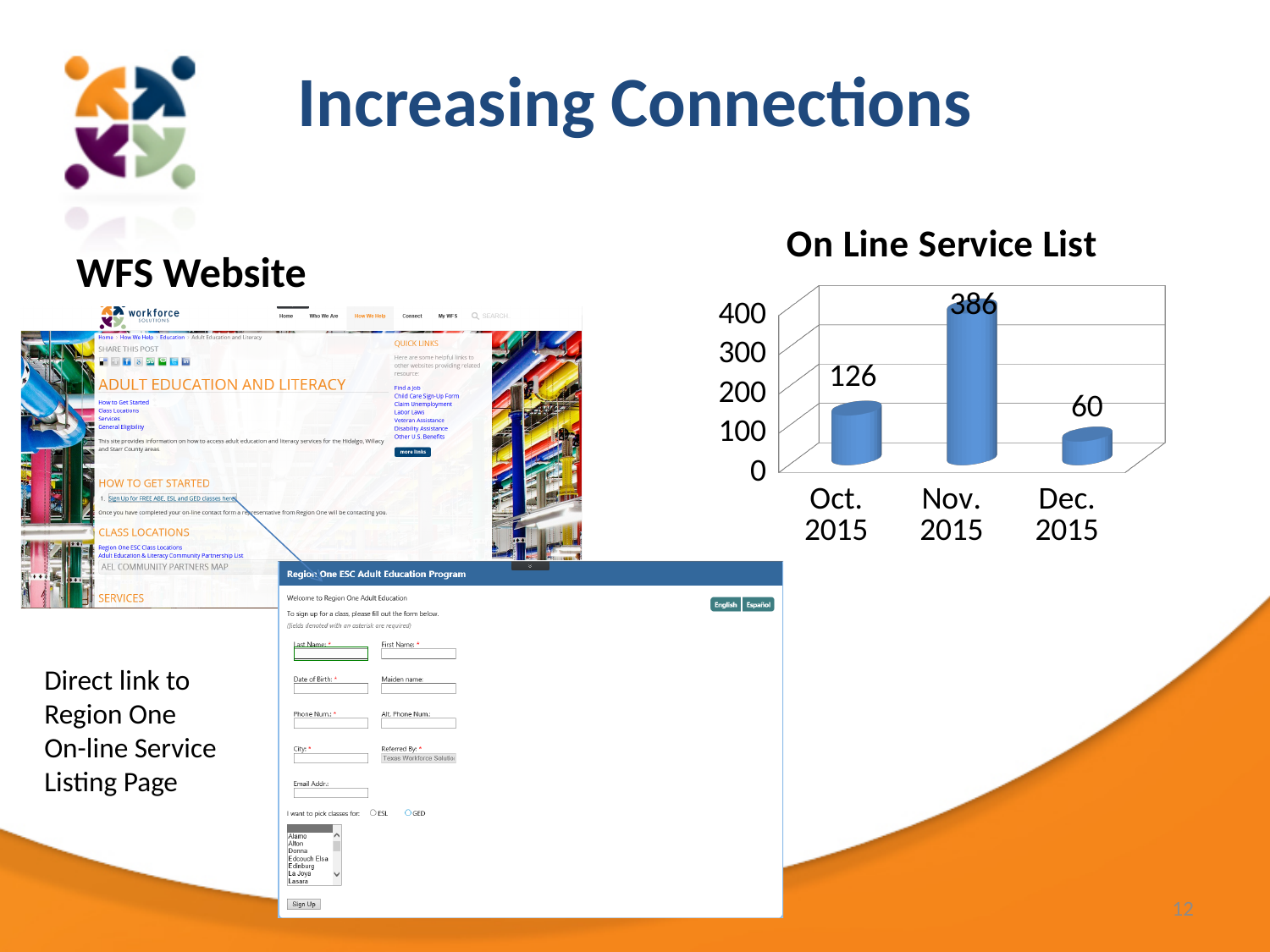
In the On Line Service List chart, which is larger, the value for Oct. 2015 or Dec. 2015? Oct. 2015 What is the difference between the Nov. 2015 and Oct. 2015 values in the On Line Service List chart? 260 How many months are shown in the On Line Service List chart? 3 Which month has the lowest value in the On Line Service List chart? Dec. 2015 What is the value for Nov. 2015 in the On Line Service List chart? 386 What is the value for Oct. 2015 in the On Line Service List chart? 126 What is the difference between the Oct. 2015 and Dec. 2015 values in the On Line Service List chart? 66 What is the title of the chart on the slide? On Line Service List What is the value for Dec. 2015 in the On Line Service List chart? 60 What kind of chart is the On Line Service List chart? bar chart Which month has the highest value in the On Line Service List chart? Nov. 2015 Is the value for Nov. 2015 in the On Line Service List chart greater or less than 300? greater